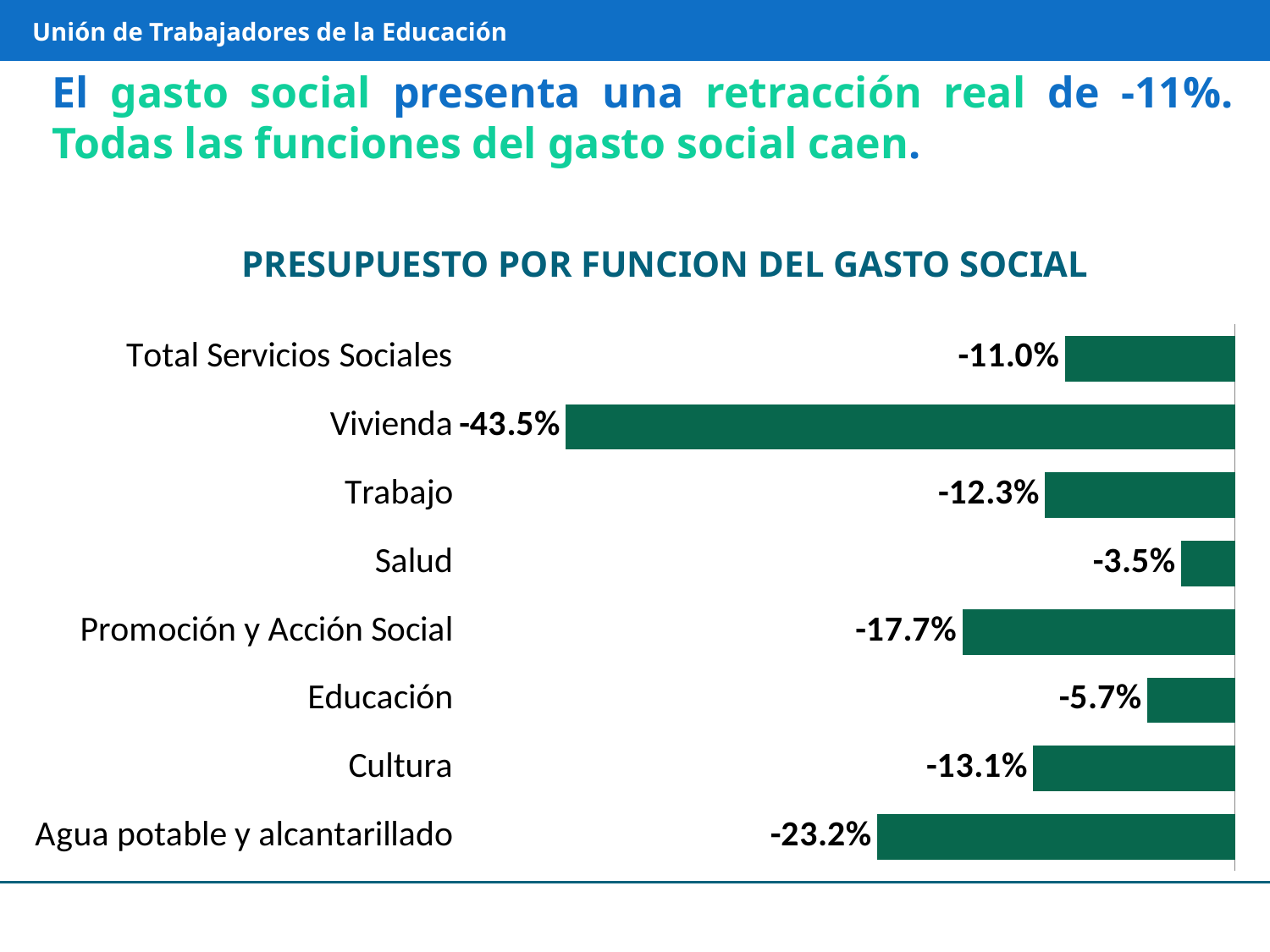
What type of chart is shown on the slide? Bar chart How many categories are plotted in the chart? 8 Which category shows the smallest decline (the highest value)? Salud Which category has the larger decline, Trabajo or Cultura? Cultura What is the value shown for Agua potable y alcantarillado? -23.2% What is the difference in percentage points between the values for Vivienda and Agua potable y alcantarillado? 20.3 percentage points What is the title of the chart? PRESUPUESTO POR FUNCION DEL GASTO SOCIAL What is the value shown for Vivienda? -43.5% What is the difference in percentage points between the values for Educación and Salud? 2.2 percentage points Which category shows the largest decline (the lowest value)? Vivienda What is the value shown for Educación? -5.7% What is the value shown for Total Servicios Sociales? -11.0%